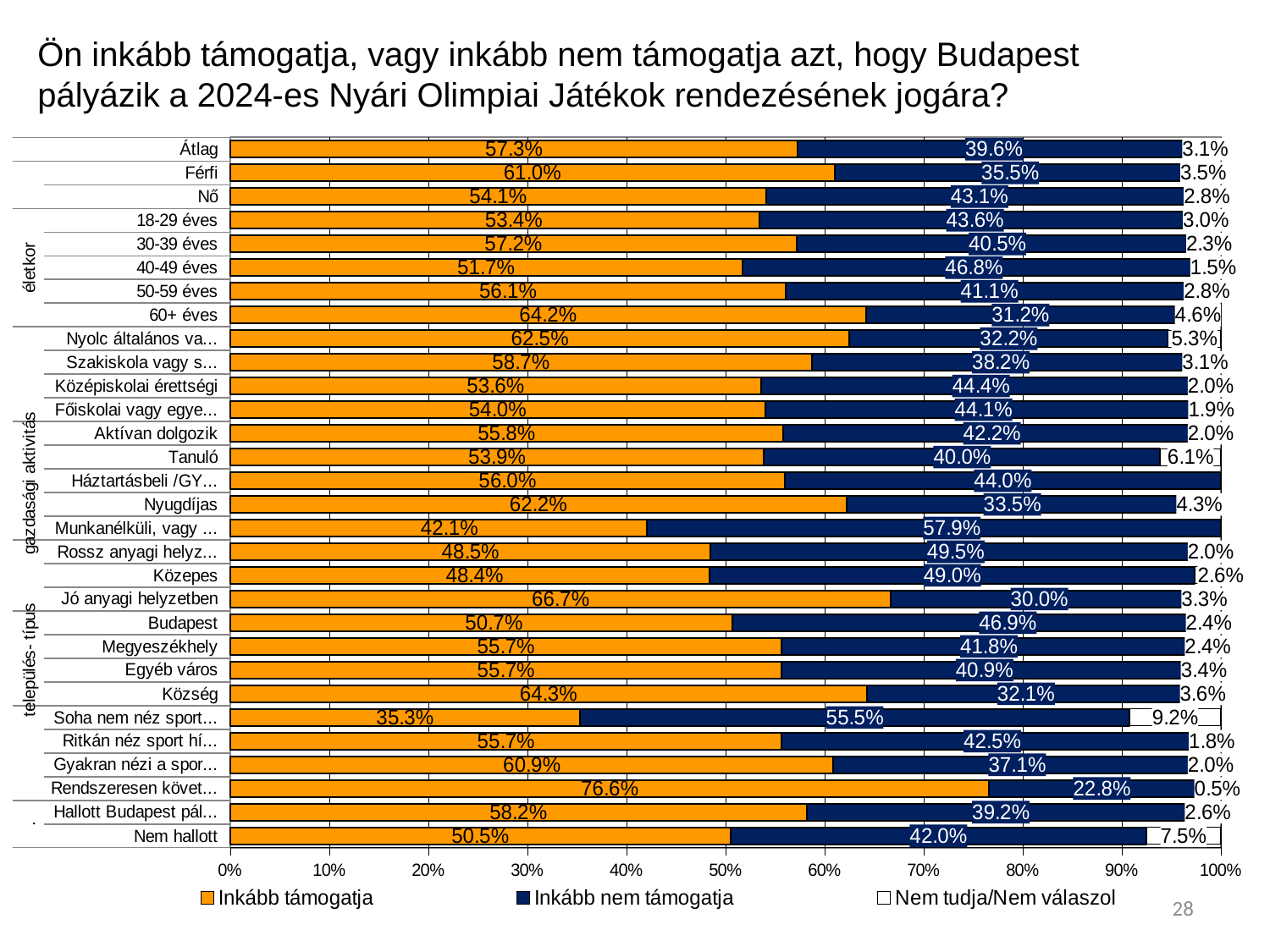
How many series does the legend list? 3 What is the value of "Inkább támogatja" for Község? 64.3% What is the value of "Nem tudja/Nem válaszol" for Nem hallott? 7.5% What is the difference between the "Inkább támogatja" values for Férfi and Nő? 6.9% What is the total of the three values for 60+ éves? 100.0% What is the value of "Inkább támogatja" for Átlag? 57.3% What is the value of "Inkább nem támogatja" for Férfi? 35.5% What kind of chart is shown on the slide? Stacked bar chart Which has a larger "Inkább nem támogatja" value, Budapest or Község? Budapest Is the "Inkább támogatja" value for Jó anyagi helyzetben greater or less than 60%? greater Which category has the lowest "Inkább támogatja" value? Soha nem néz sport... Which category has the highest "Inkább támogatja" value? Rendszeresen követ...